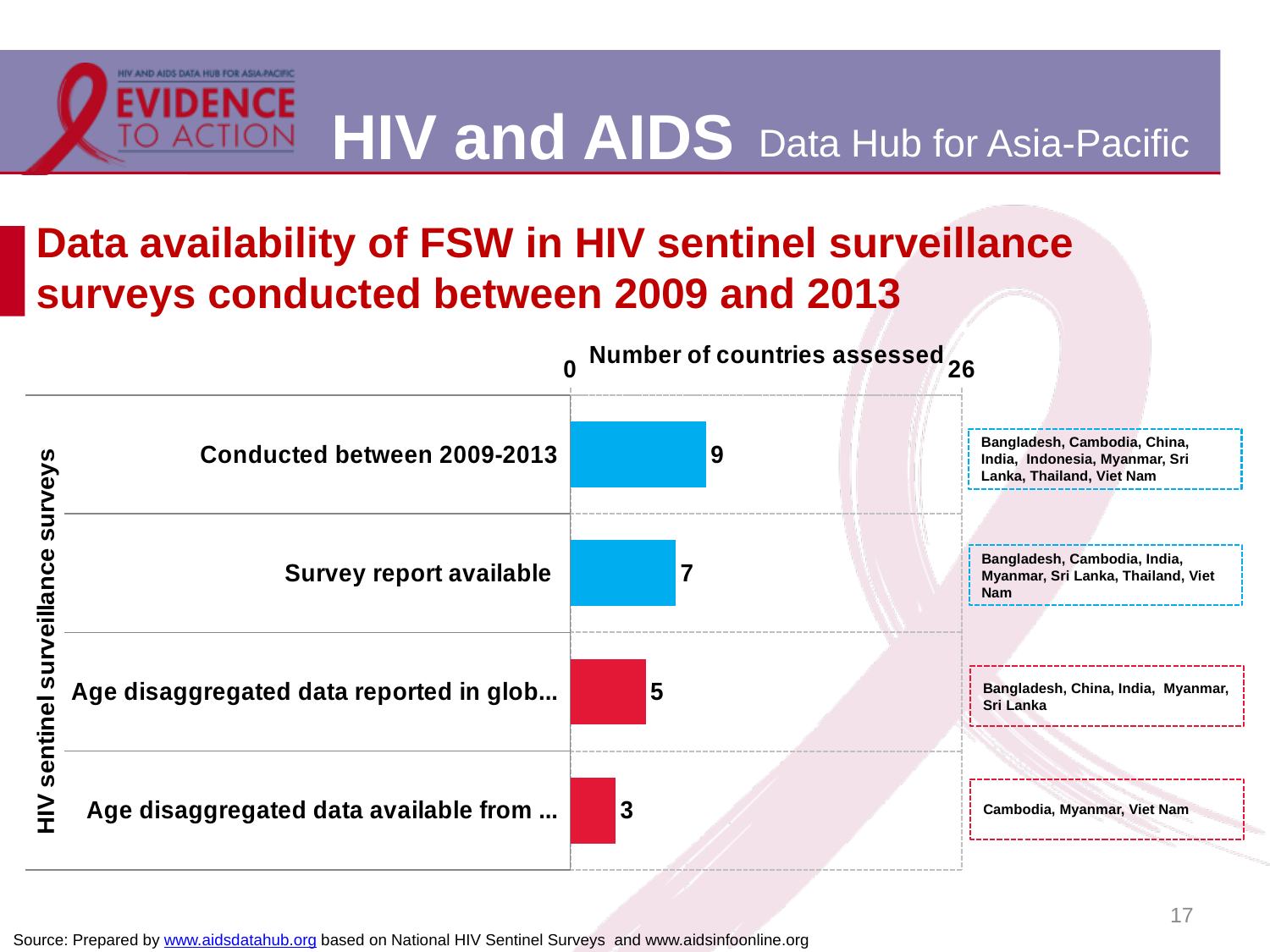
Which category has the lowest number of countries assessed? Age disaggregated data available from ... Which category has the highest number of countries assessed? Conducted between 2009-2013 What kind of chart is shown on the slide? Bar chart What is the value for 'Age disaggregated data available from ...'? 3 What is the title of the chart's value axis? Number of countries assessed Which is larger: the value for 'Survey report available' or for 'Age disaggregated data reported in glob...'? Survey report available What is the maximum value shown on the chart's axis? 26 How many categories are shown in the chart? 4 What is the number of countries assessed for 'Survey report available'? 7 What is the difference between the values for 'Conducted between 2009-2013' and 'Survey report available'? 2 What is the number of countries assessed for 'Conducted between 2009-2013'? 9 What is the value for 'Age disaggregated data reported in glob...'? 5